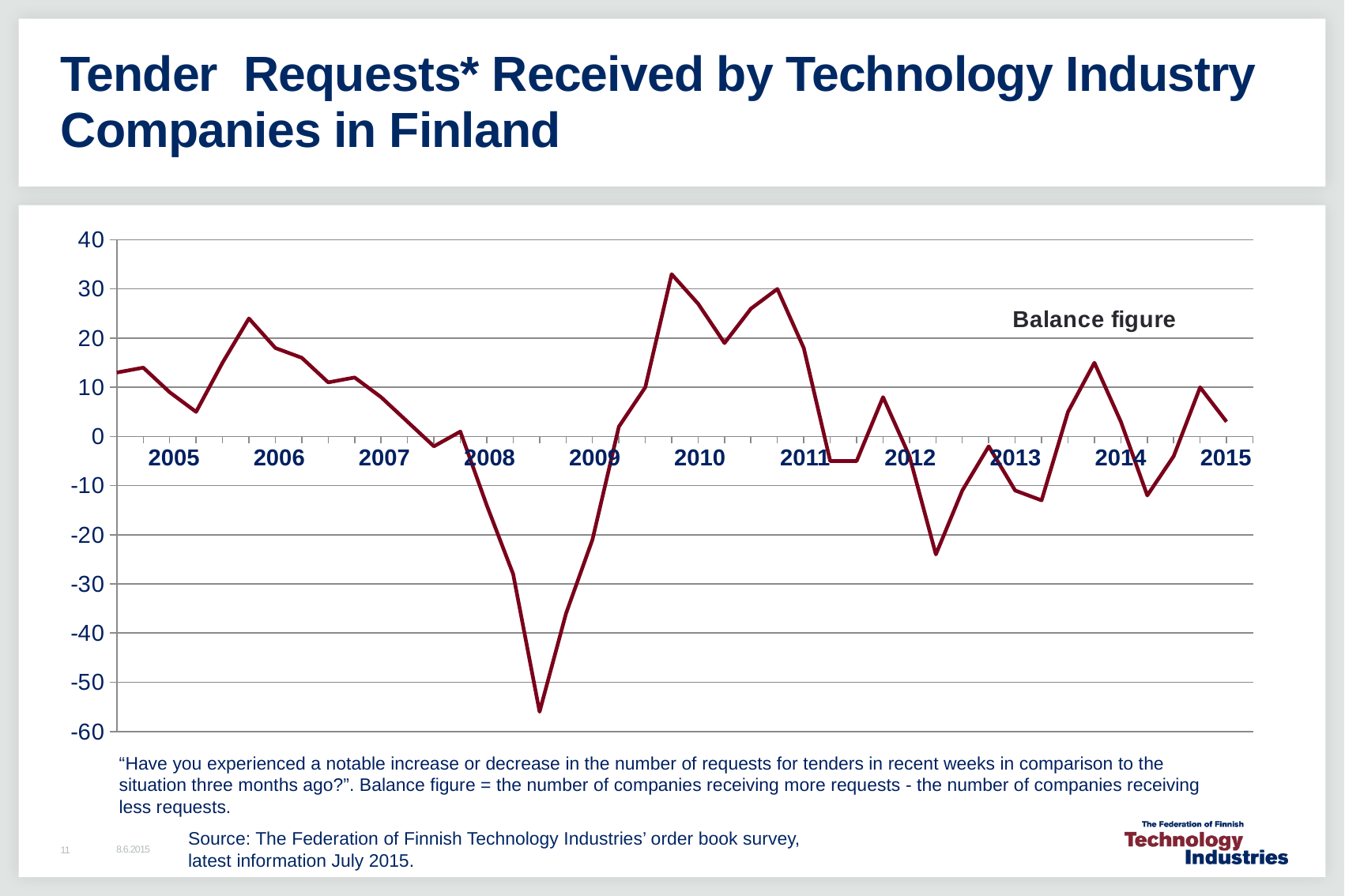
Is the highest value of the balance figure, reached just before 2010, greater or less than 30? greater Does the balance figure rise or fall from its low point in 2008 to its peak just before 2010? rise In which year does the balance figure reach its lowest point? 2009 Which is lower: the low point of the balance figure in 2008 or the low point in 2012? 2008 Is the balance figure at the start of 2005 greater or less than 10? greater How many year labels are shown along the x axis? 11 Is the lowest value of the balance figure in 2012 greater or less than -20? less What kind of chart is shown on the slide? line chart What label is shown for the plotted series on the chart? Balance figure What is the title of the chart on the slide? Tender Requests* Received by Technology Industry Companies in Finland